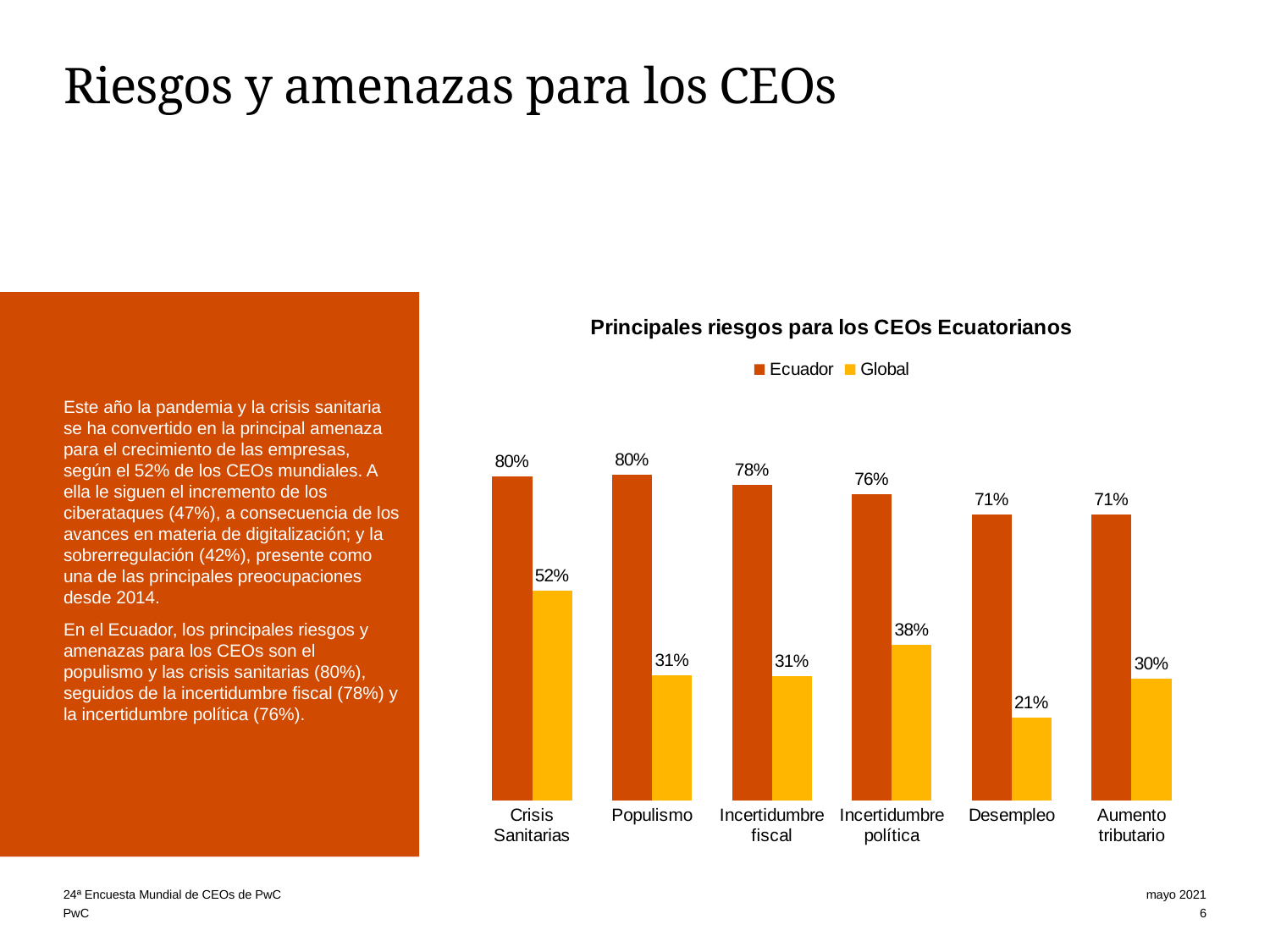
Which category has the highest Global value? Crisis Sanitarias What is the Global value for Desempleo? 21% What is the title of the chart? Principales riesgos para los CEOs Ecuatorianos Which category has the lowest Global value? Desempleo What is the Global value for Crisis Sanitarias? 52% What kind of chart is shown? Bar chart How many categories are shown on the x axis? 6 Which is larger: the Global value for Incertidumbre política or the Global value for Aumento tributario? Incertidumbre política What is the Ecuador value for Incertidumbre fiscal? 78% Do the Ecuador values rise or fall from left to right across the categories? Fall How many series does the legend list? 2 What is the difference between the Ecuador and Global values for Populismo? 49 percentage points